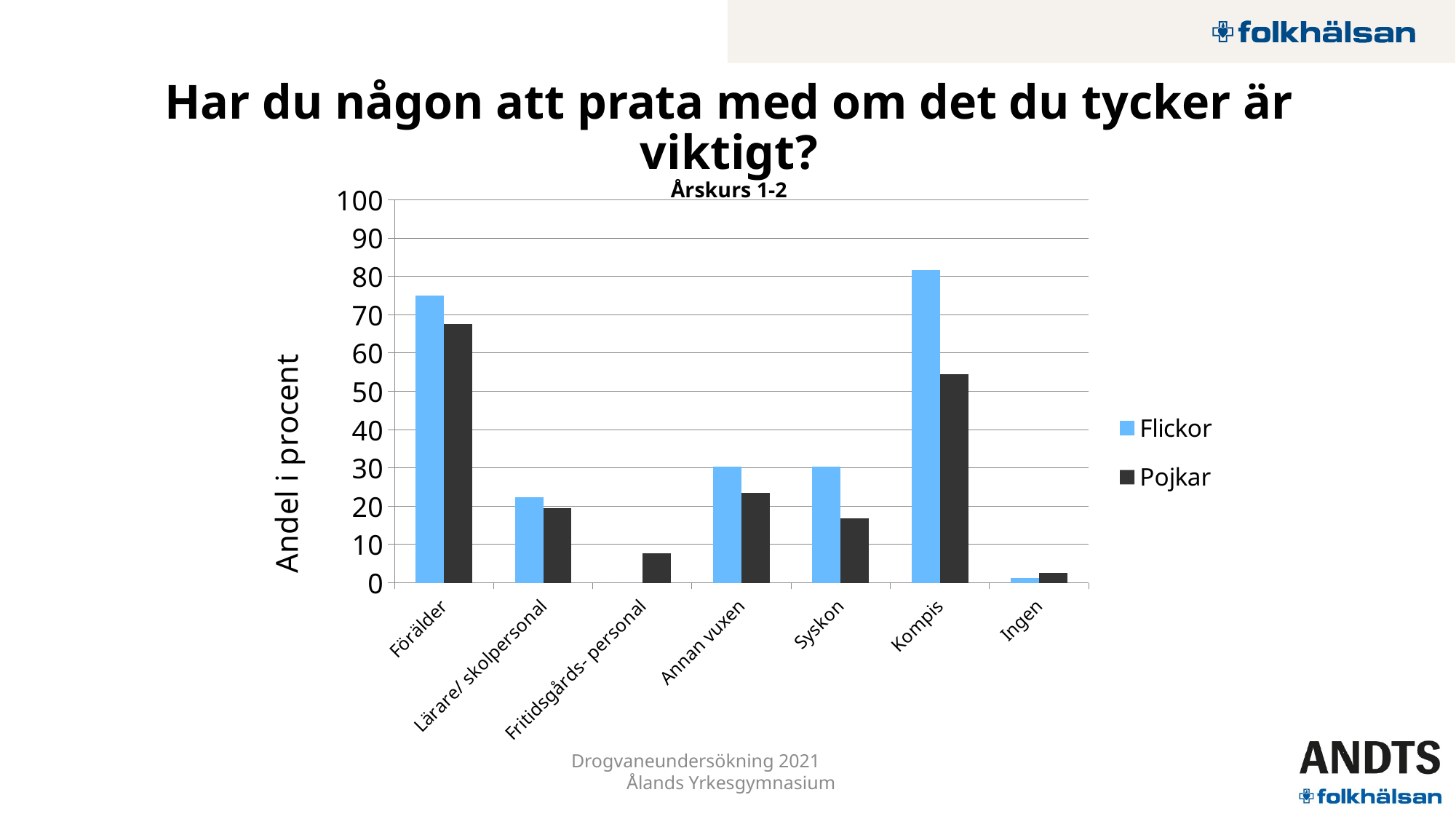
Is the value for Flickor in the Förälder category greater or less than 70? greater Is the value for Pojkar in the Syskon category greater or less than 20? less Which category has the highest value for Pojkar? Förälder Which category has the highest value for Flickor? Kompis What is the label of the vertical axis? Andel i procent Is the value for Pojkar in the Fritidsgårds- personal category greater or less than 10? less How many series does the legend list? 2 What kind of chart is shown on the slide? bar chart How many categories are shown on the x axis of the chart? 7 Which category has the lowest value for Pojkar? Ingen In the Kompis category, which series has the larger value, Flickor or Pojkar? Flickor